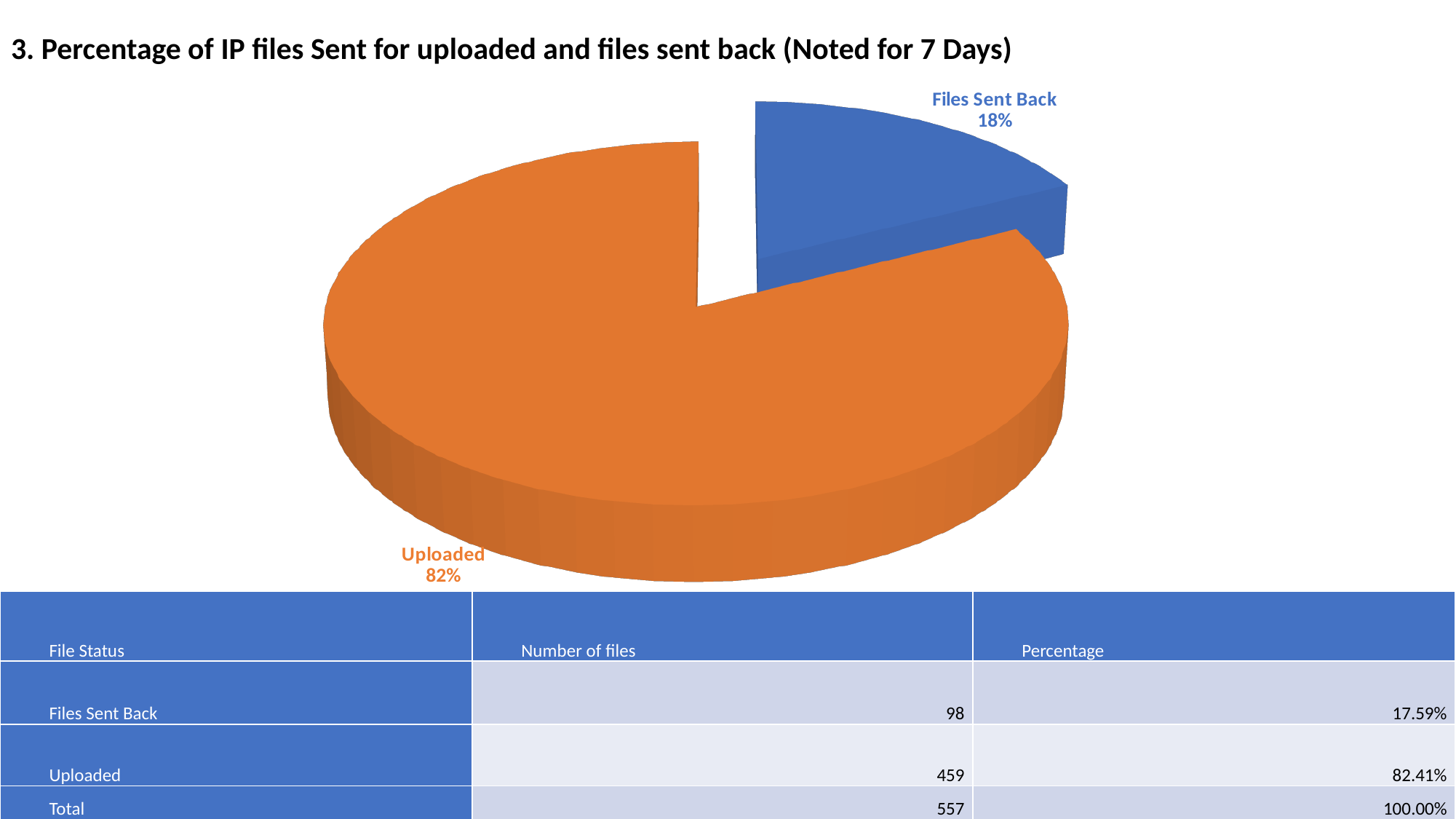
What percentage does the pie chart show for Files Sent Back? 18% Is the Files Sent Back slice's share of the pie greater or less than 25%? less Which slice of the pie chart is the largest? Uploaded What colour is the Files Sent Back slice in the pie chart? blue What kind of chart is shown on the slide? pie chart Which slice of the pie chart is the smallest? Files Sent Back What percentage does the pie chart show for Uploaded? 82% Is the Uploaded slice's share of the pie greater or less than 50%? greater How many slices does the pie chart have? 2 What colour is the Uploaded slice in the pie chart? orange Which is larger in the pie chart, Uploaded or Files Sent Back? Uploaded What is the difference in percentage points between the Uploaded and Files Sent Back slices as labelled on the pie chart? 64